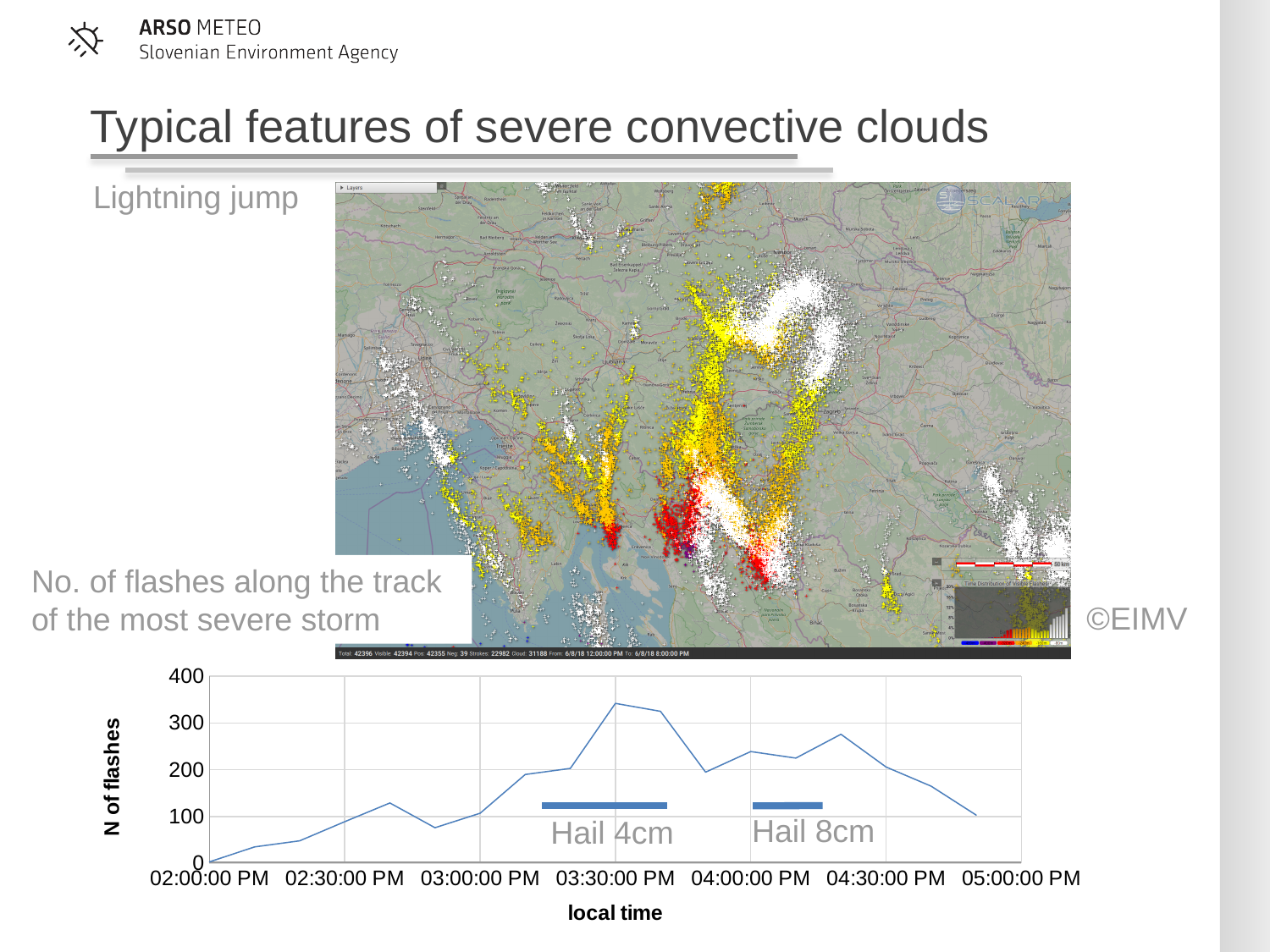
Which has more flashes, 03:30:00 PM or 04:00:00 PM? 03:30:00 PM What kind of chart is shown at the bottom of the slide? line chart At which labelled time is the number of flashes lowest? 02:00:00 PM How many time labels are shown on the horizontal axis of the line chart? 7 What is the label of the horizontal axis of the line chart? local time What is the label of the vertical axis of the line chart? N of flashes Is the number of flashes at 03:30:00 PM greater or less than 300? greater At which labelled time does the number of flashes reach its highest value? 03:30:00 PM Is the number of flashes at 04:00:00 PM greater or less than 200? greater Is the number of flashes at 02:00:00 PM greater or less than 100? less